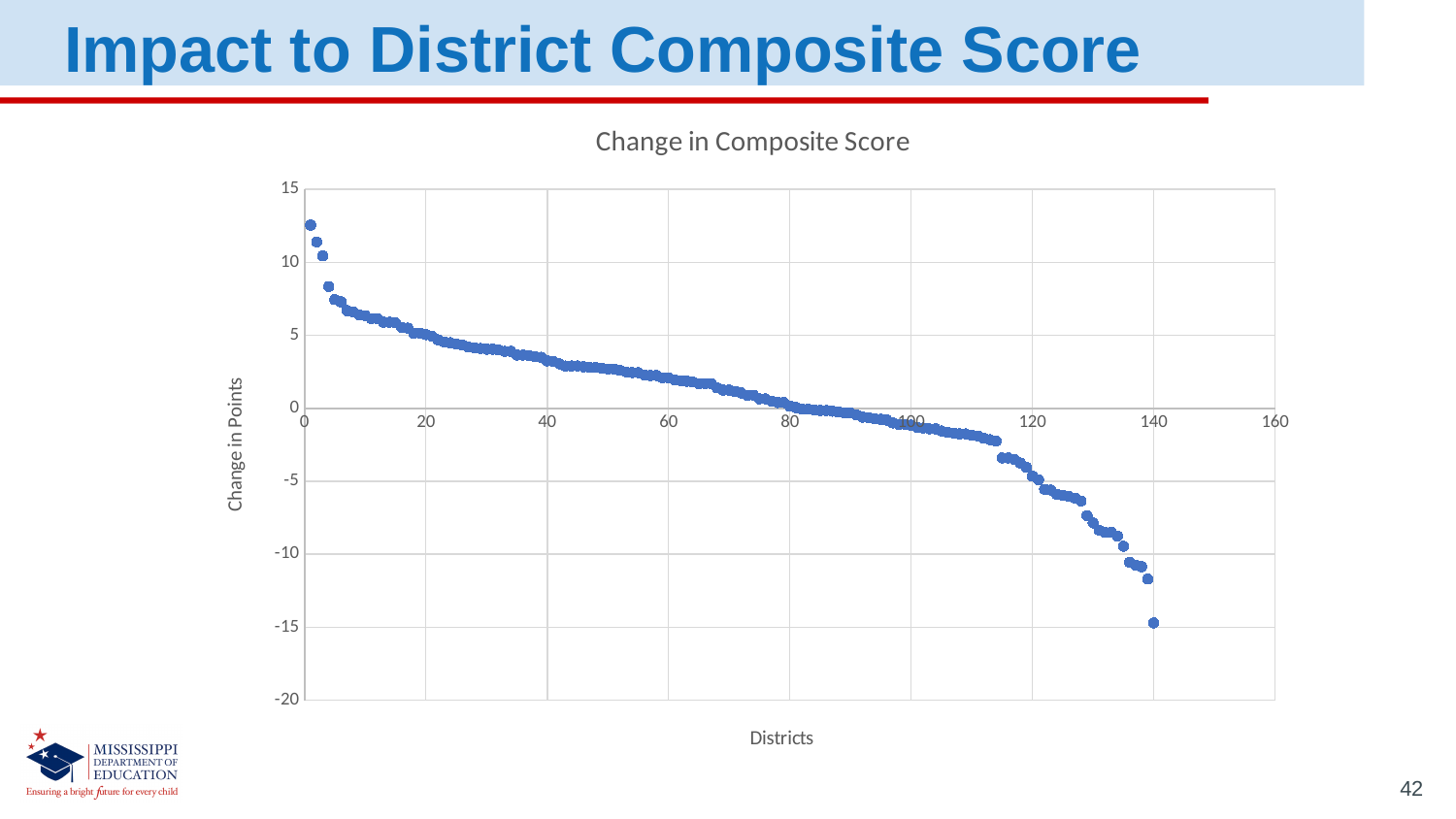
Do the plotted values rise or fall as you move from left to right along the x axis? fall Is the value for the district at x = 60 greater or less than 0? greater What kind of chart is shown on the slide? scatter chart Is the value for the district at x = 100 greater or less than 0? less Is the value for the last (rightmost) district greater or less than -10? less Which end of the x axis has the district with the lowest change in points, the left or the right? right What is the title of the chart? Change in Composite Score What is the label of the vertical axis? Change in Points Which end of the x axis has the district with the highest change in points, the left or the right? left